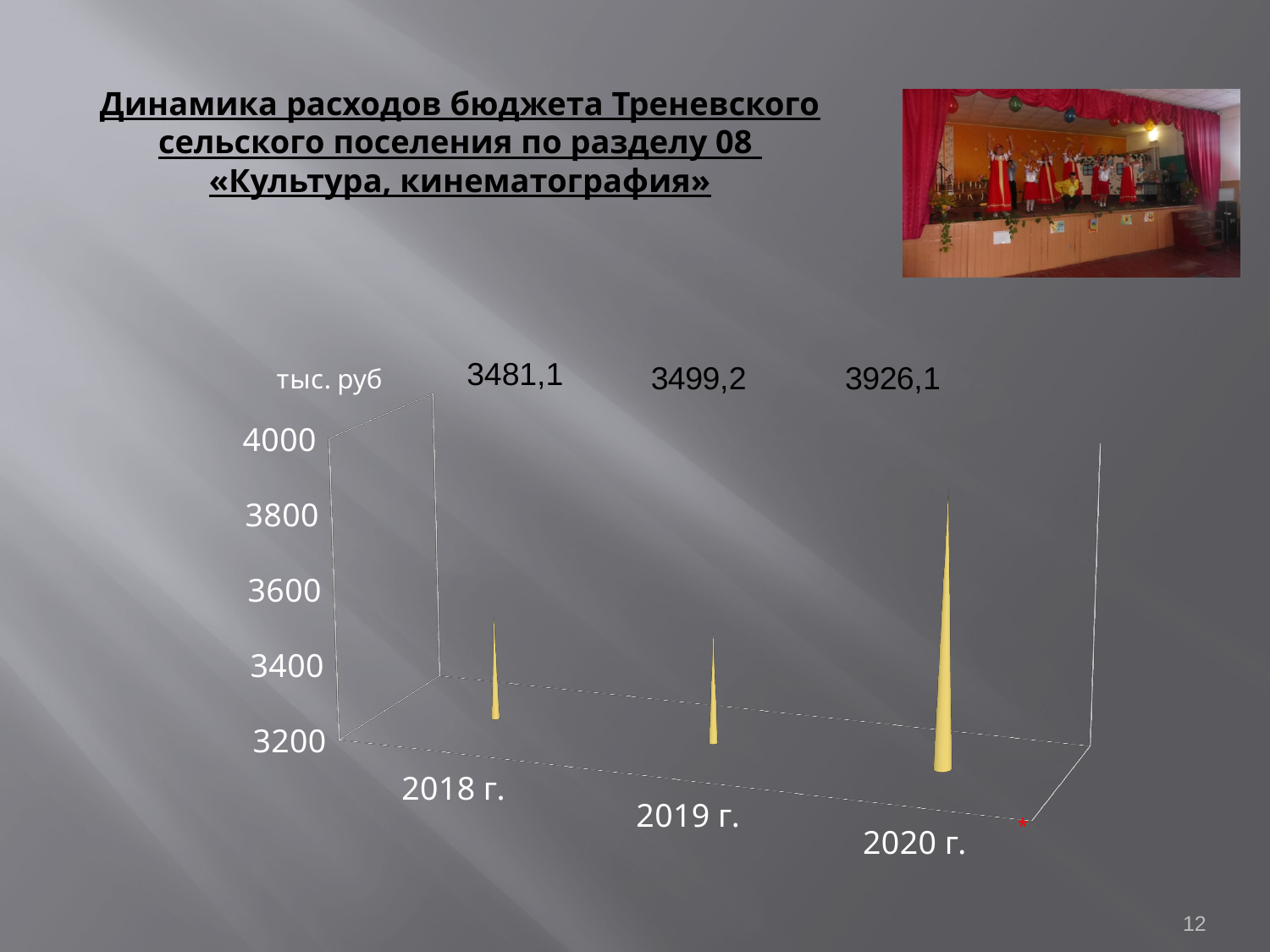
What is the difference between the values for 2020 г. and 2018 г.? 445,0 What is the value for 2020 г. on the chart? 3926,1 Which year has the lowest value on the chart? 2018 г. What is the value for 2019 г. on the chart? 3499,2 Which is larger, the value for 2019 г. or the value for 2018 г.? 2019 г. Is the value for 2020 г. greater or less than 3800? greater What is the difference between the values for 2019 г. and 2018 г.? 18,1 What unit of measurement is indicated on the chart? тыс. руб Which year has the highest value on the chart? 2020 г. How many years are shown on the chart? 3 What is the value for 2018 г. on the chart? 3481,1 Do the values rise or fall from 2018 г. to 2020 г.? rise